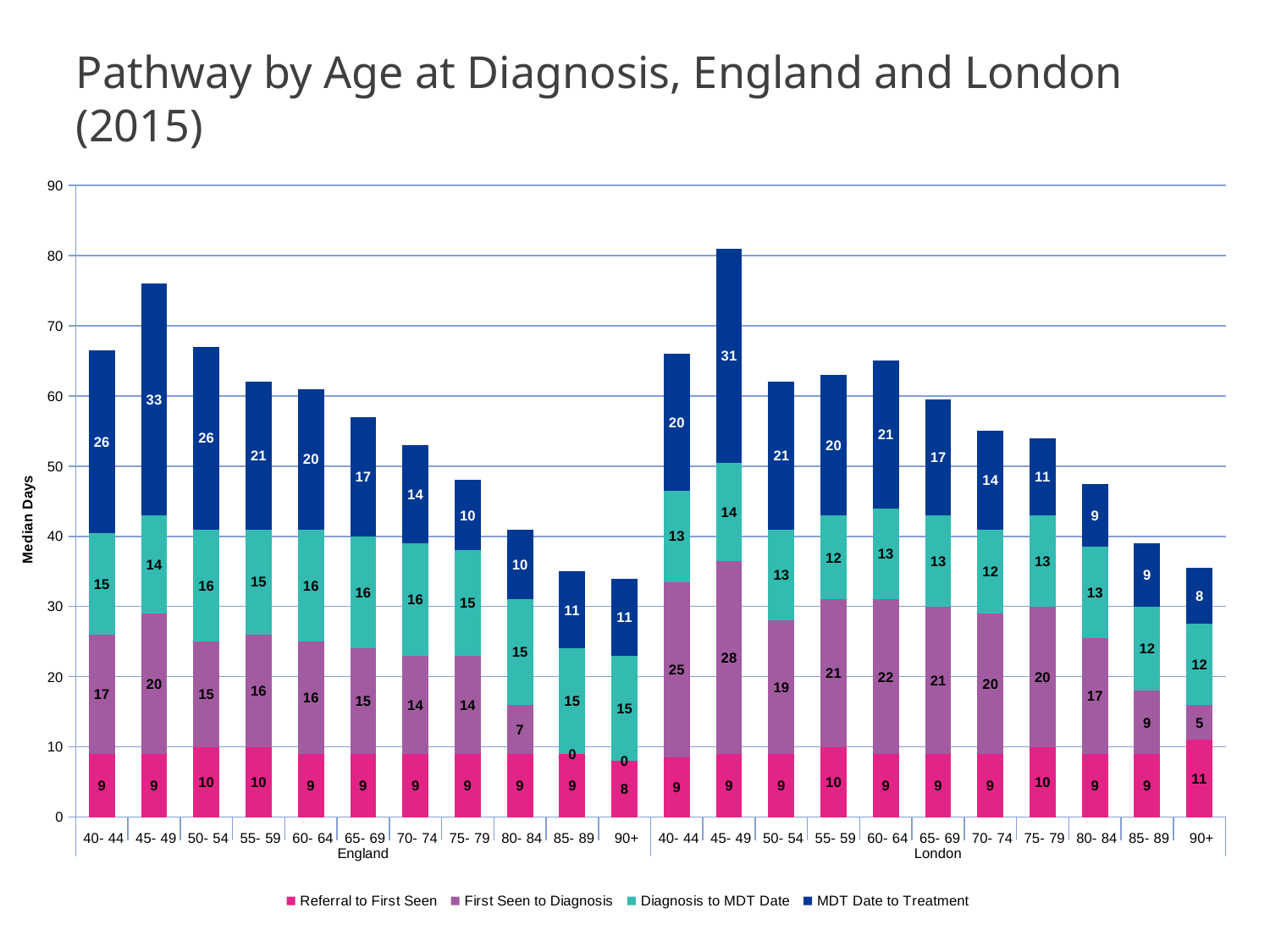
What is the MDT Date to Treatment value for the 45-49 age group in England? 33 What is the First Seen to Diagnosis value for the 45-49 age group in London? 28 Which has the larger First Seen to Diagnosis value for the 40-44 age group, England or London? London What is the label on the vertical axis? Median Days Is the total stacked bar for the 45-49 age group in England greater or less than 70? greater Which England age group has the lowest Referral to First Seen value? 90+ What kind of chart is shown on the slide? Stacked bar chart What is the difference between the MDT Date to Treatment values for England 45-49 and England 90+? 22 What is the total of the stacked bar for the 85-89 age group in England? 35 How many series does the legend list? 4 How many age groups are shown for each region? 11 Which London age group has the highest MDT Date to Treatment value? 45-49